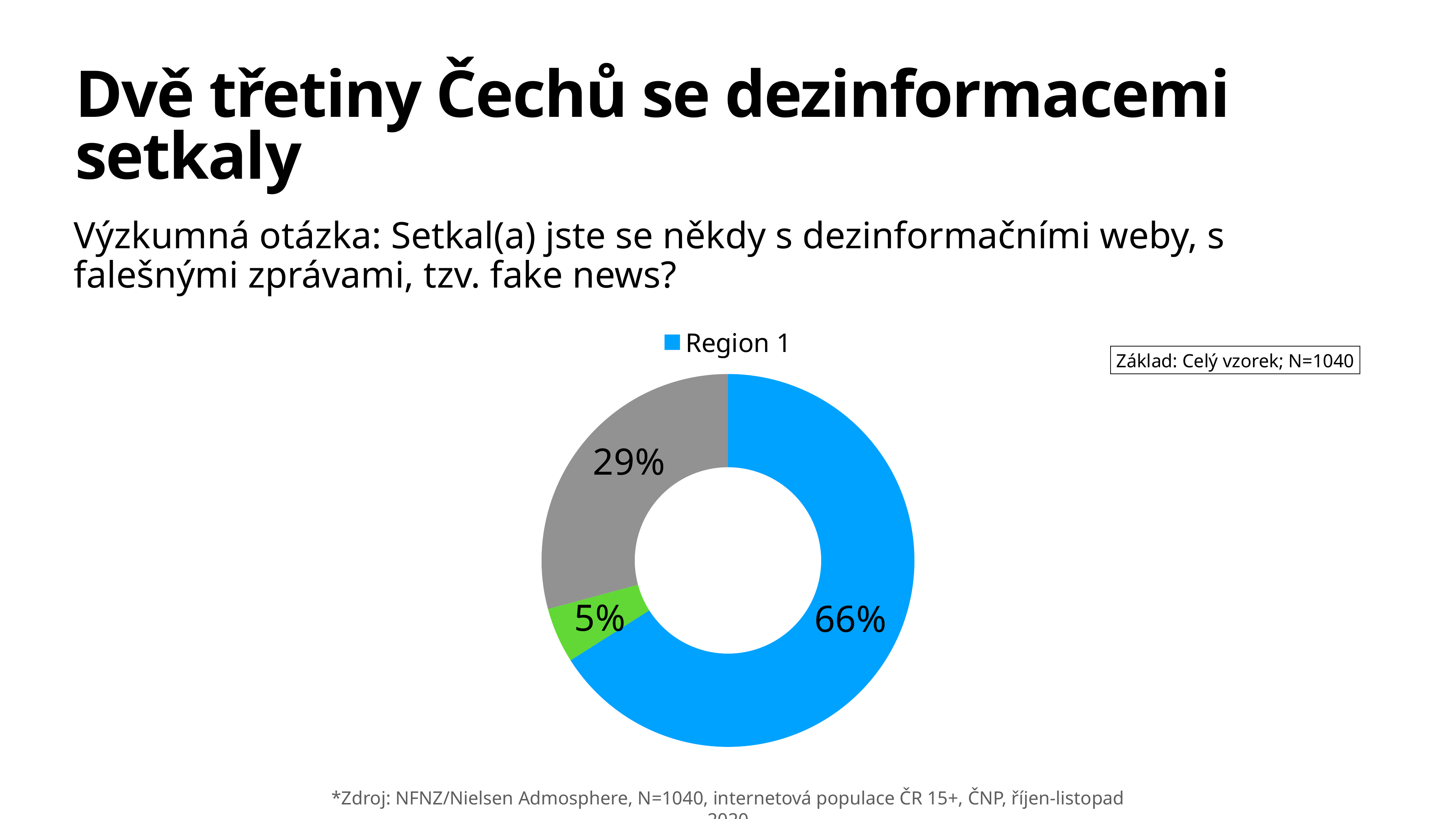
Which colour slice is the largest in the doughnut chart? blue How many entries does the chart legend list? 1 What is the value of the blue slice of the doughnut chart? 66% Which colour slice is the smallest in the doughnut chart? green What is the difference between the blue slice and the grey slice? 37% Which is larger, the grey slice or the green slice? grey slice What kind of chart is shown on the slide? doughnut chart What is the legend entry shown above the doughnut chart? Region 1 What is the value of the grey slice of the doughnut chart? 29% How many slices does the doughnut chart have? 3 What is the difference between the grey slice and the green slice? 24% What is the value of the green slice of the doughnut chart? 5%